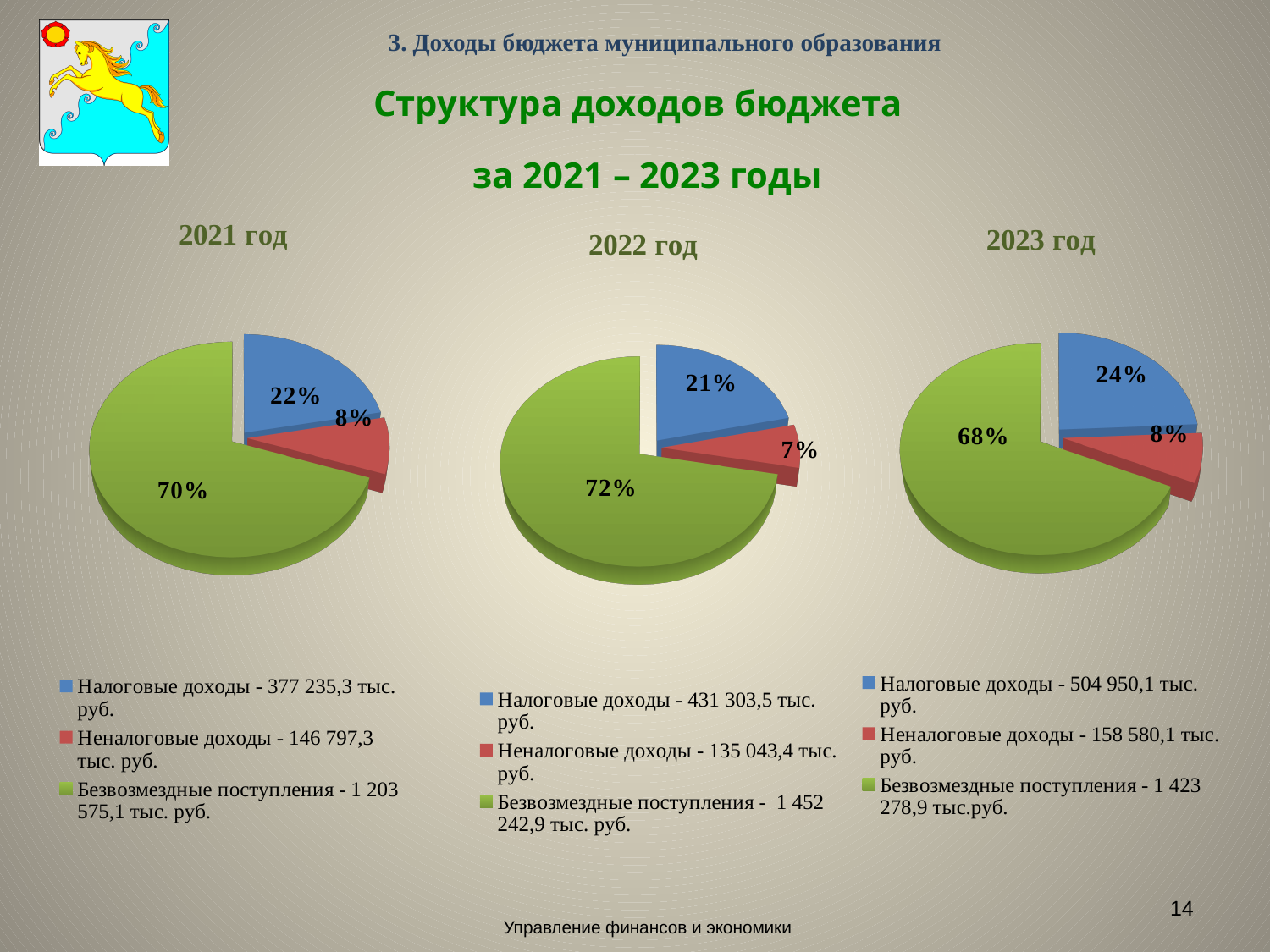
In the 2022 год chart, which slice is larger: Налоговые доходы or Неналоговые доходы? Налоговые доходы In the 2022 год chart, which category has the largest slice? Безвозмездные поступления How many entries does the legend of the 2023 год chart list? 3 In the 2023 год chart, which category has the smallest slice? Неналоговые доходы In the 2023 год chart, what is the difference in percentage points between Безвозмездные поступления and Налоговые доходы? 44 In the 2021 год chart, what share of the pie is Налоговые доходы? 22% In the 2022 год chart, what share of the pie is Неналоговые доходы? 7% How many slices does the 2021 год pie chart have? 3 In the 2021 год chart, what share of the pie is Безвозмездные поступления? 70% In the 2022 год chart legend, what amount is given for Налоговые доходы? 431 303,5 тыс. руб. What kind of chart is used for the 2021 год chart? pie chart